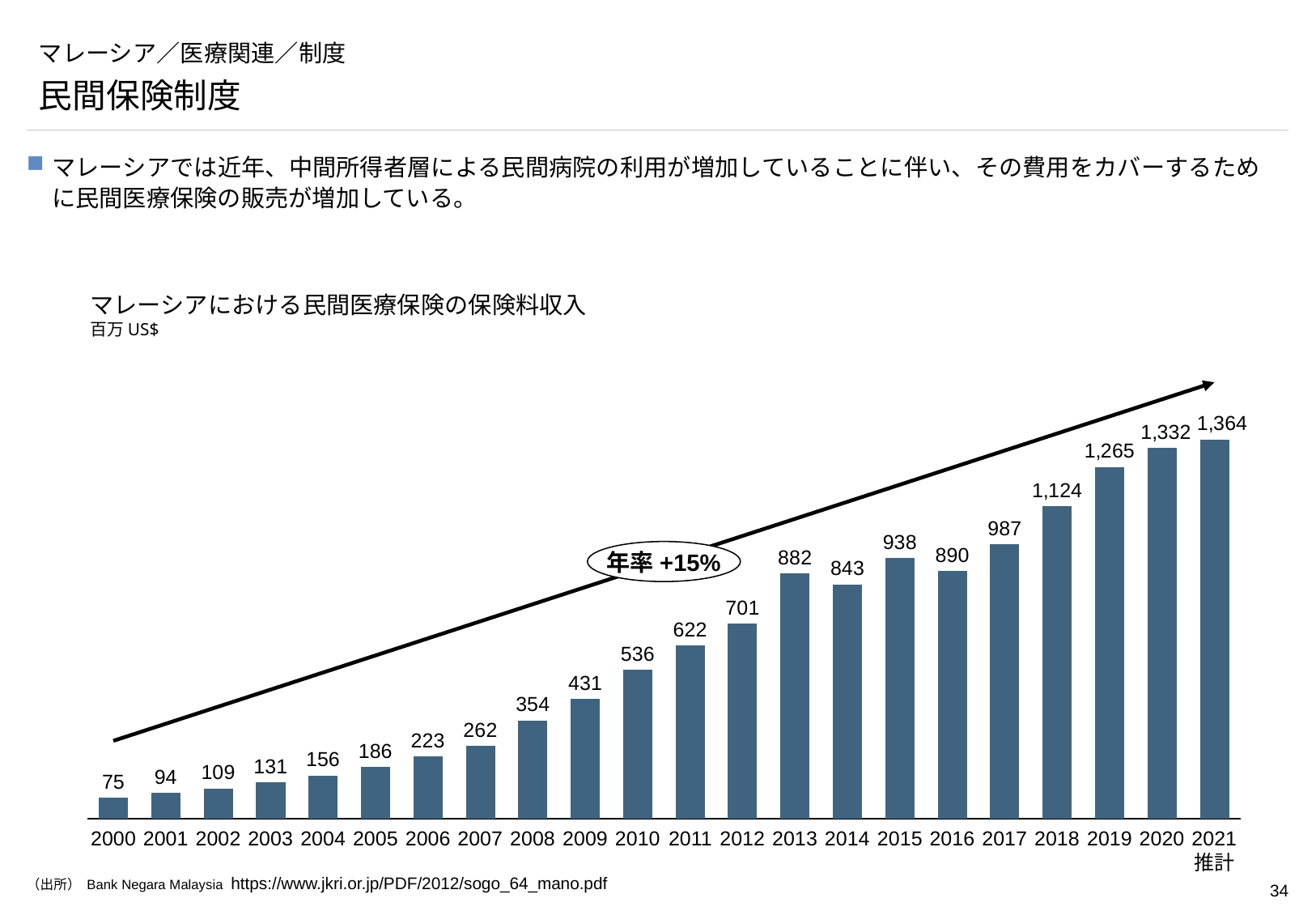
How many years are shown on the x axis? 22 Which year has the lowest value? 2000 What unit is given under the chart title? 百万 US$ Do the values generally rise or fall from 2000 to 2021? rise What is the value for 2010? 536 What is the value for 2021 (推計)? 1,364 What kind of chart is this? bar chart What is the value for 2000? 75 Which year has the highest value? 2021 What is the difference between the values for 2013 and 2014? 39 What annual growth rate is written in the oval on the chart? 年率 +15% Which is larger, the value for 2015 or the value for 2016? 2015